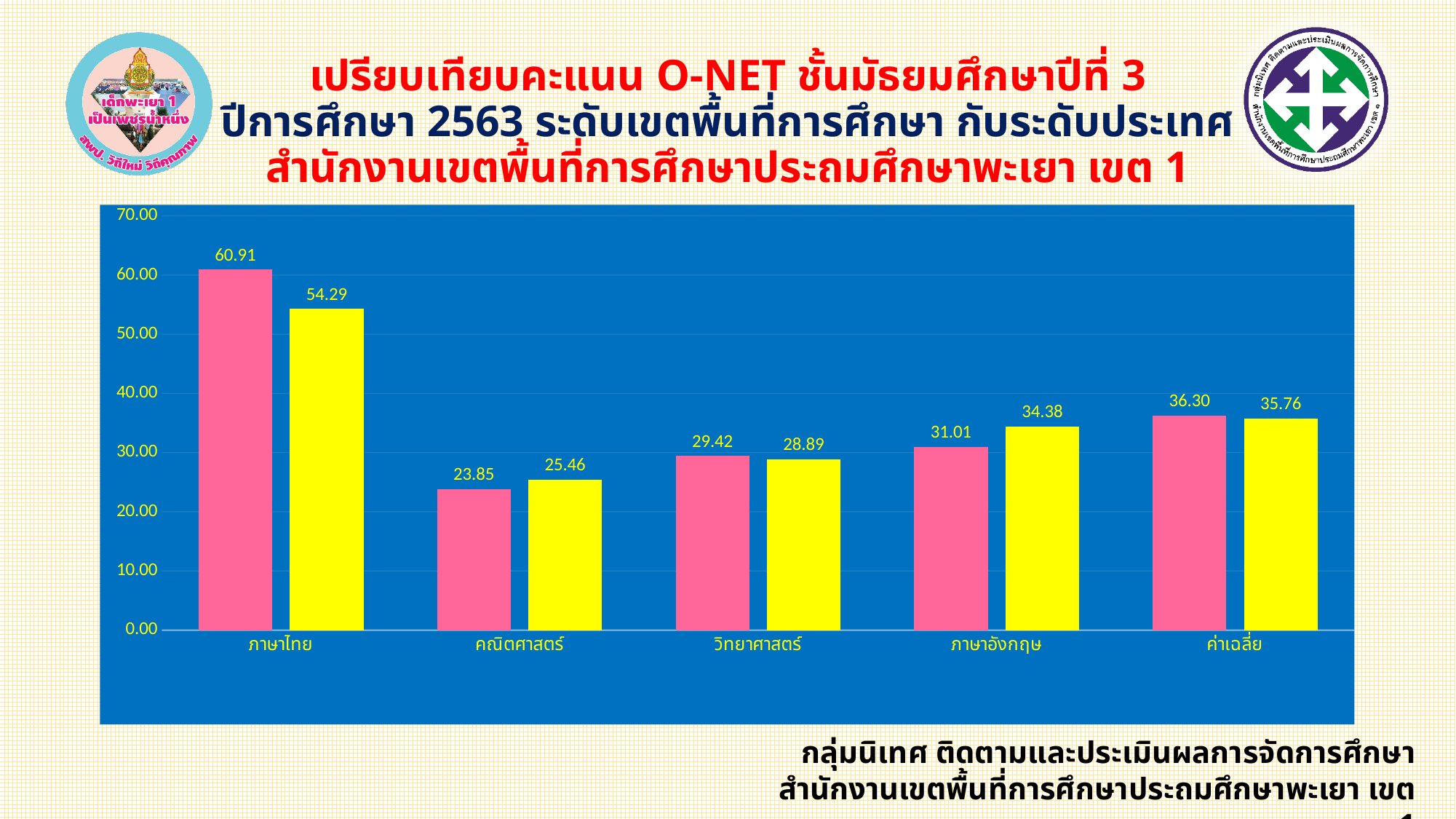
What is the difference between the pink and yellow bars for คณิตศาสตร์? 1.61 What is the value of the pink bar for ภาษาไทย? 60.91 Is the pink bar for วิทยาศาสตร์ greater or less than 30.00? less What is the value of the pink bar for ภาษาอังกฤษ? 31.01 Which category has the highest pink bar? ภาษาไทย What is the value of the yellow bar for คณิตศาสตร์? 25.46 How many categories are shown on the x axis? 5 What kind of chart is shown on the slide? bar chart What is the difference between the pink and yellow bars for ภาษาไทย? 6.62 What is the value of the yellow bar for ค่าเฉลี่ย? 35.76 For ภาษาอังกฤษ, which bar is larger, the pink or the yellow one? yellow Which category has the lowest yellow bar? คณิตศาสตร์